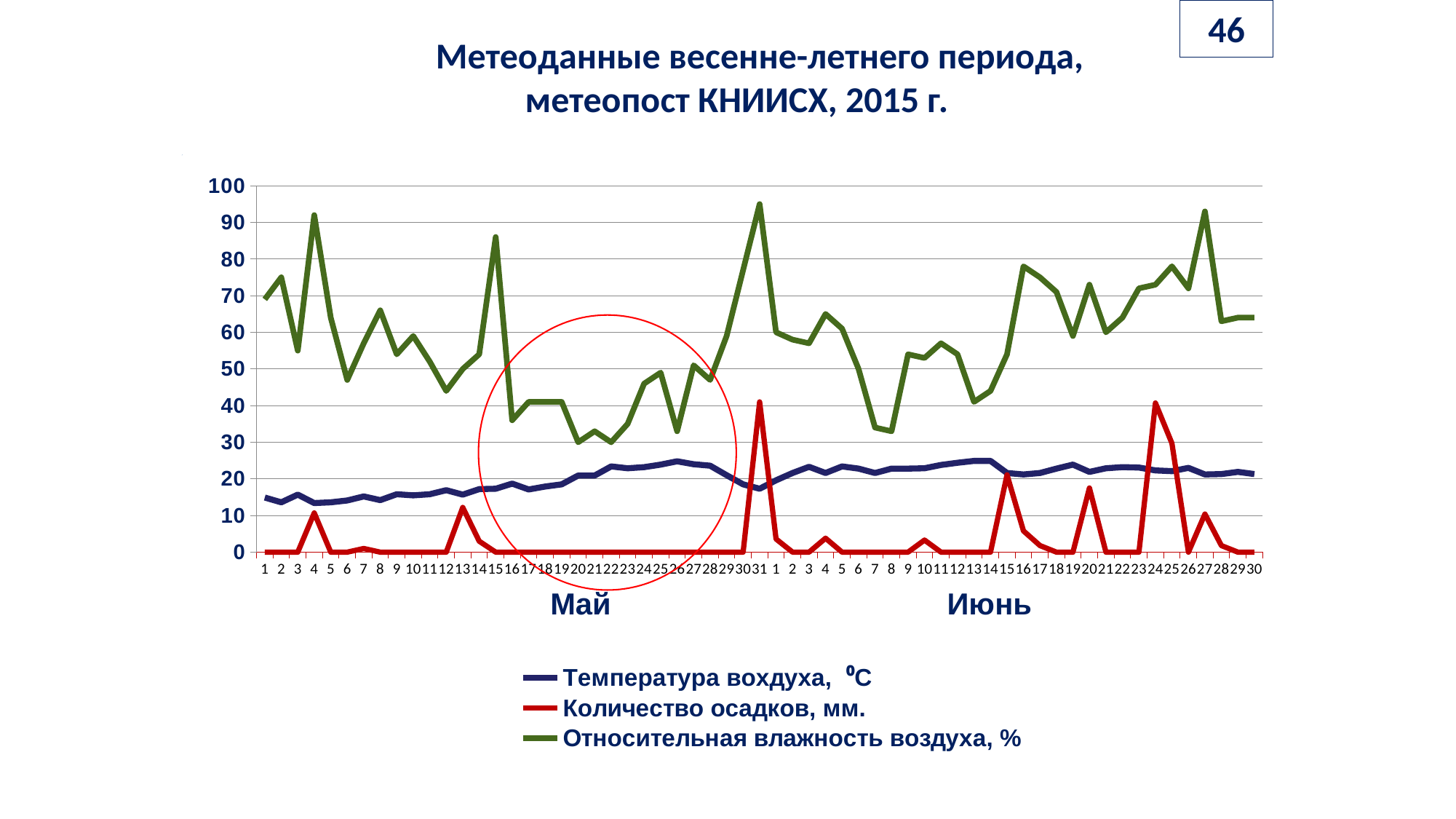
Which is higher: relative humidity on 4 May or on 6 May? 4 May Which two months are labelled on the x axis? Май, Июнь Is the relative humidity on 7 June greater or less than 40? less Which series is drawn in green? Относительная влажность воздуха, % Is the precipitation on 31 May greater or less than 30? greater How many days (x-axis points) are plotted in total across May and June? 61 Is the relative humidity on 4 May greater or less than 80? greater How many series does the legend list? 3 Which is higher: air temperature on 1 May or on 14 June? 14 June Does the air temperature generally rise or fall from 1 May to 26 May? rise What kind of chart is shown on the slide? line chart